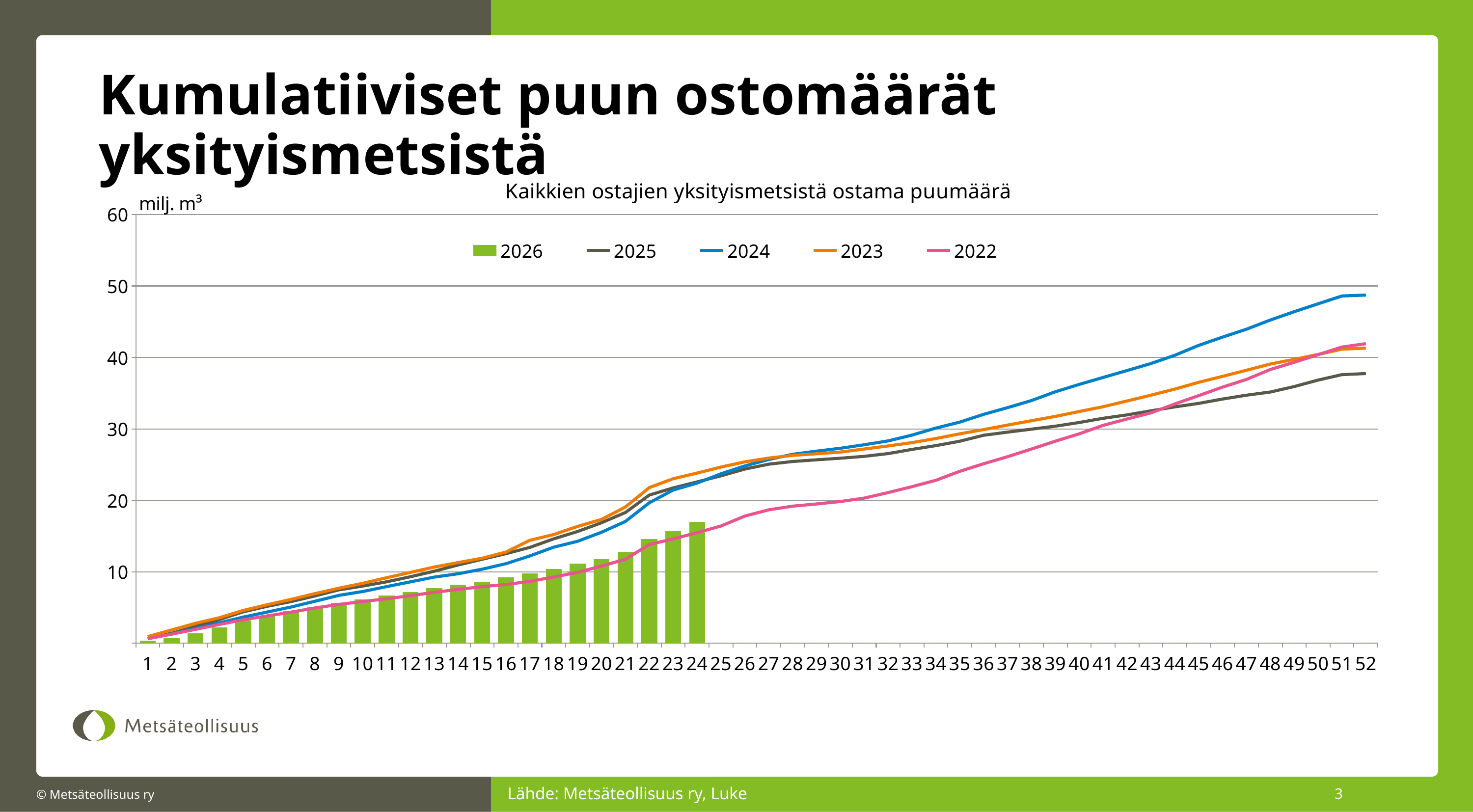
How many weeks are shown on the x axis? 52 What unit is shown on the y axis? milj. m³ How many series does the legend list? 5 Which series has the lowest value at week 52? 2025 What kind of chart is this? Combined bar and line chart Is the value for 2024 at week 52 greater or less than 40? greater At week 20, which series is larger, 2023 or 2022? 2023 Which series has the highest value at week 52? 2024 Do the values of the 2024 line rise or fall along the x axis? rise Is the value for 2025 at week 52 greater or less than 40? less Up to which week are bars plotted for the 2026 series? 24 Is the 2026 bar at week 24 greater or less than 20? less